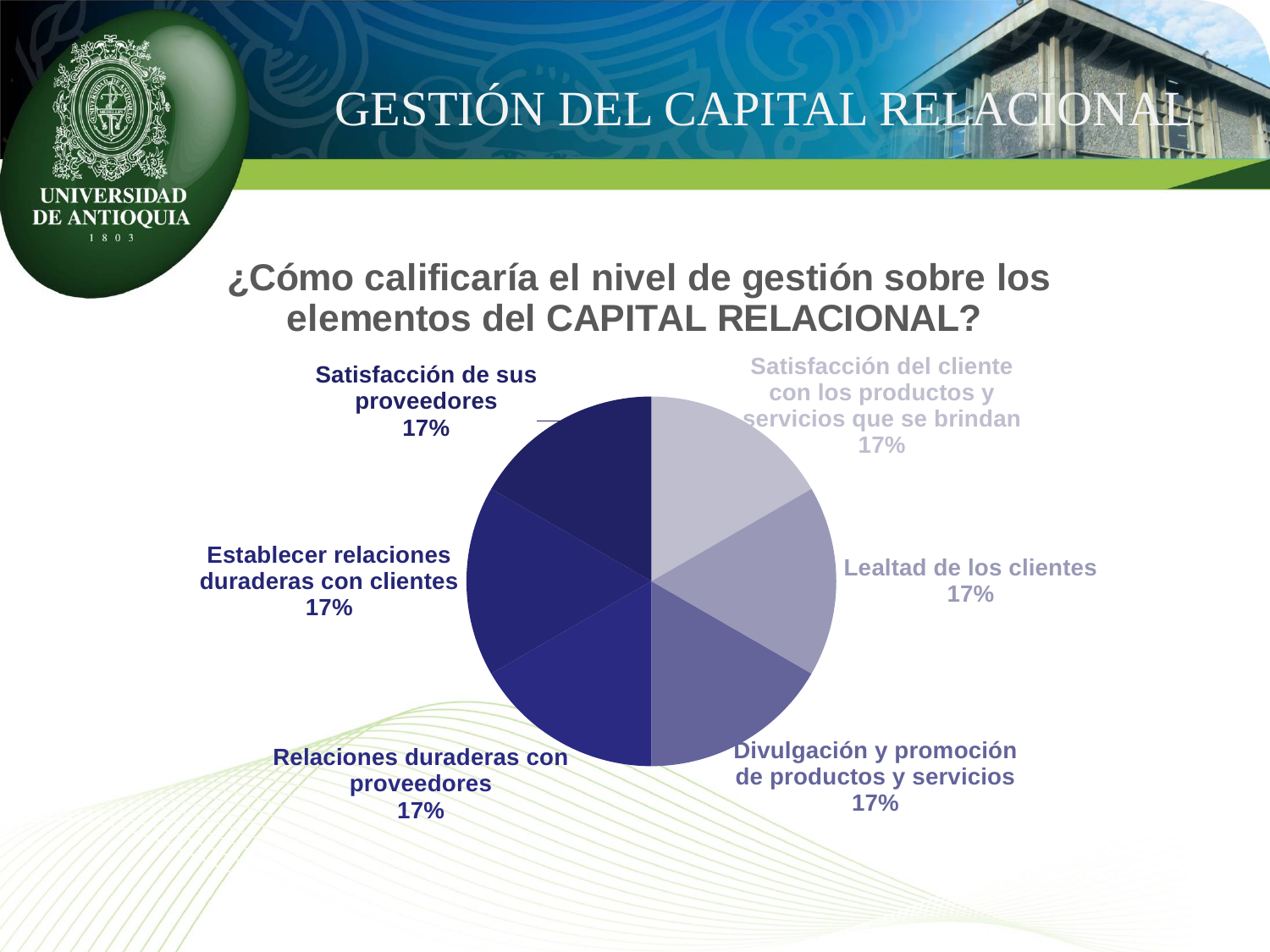
What kind of chart is shown on the slide? pie chart What share of the pie does "Lealtad de los clientes" represent? 17% Do all slices of the pie chart show the same percentage? Yes What is the value for "Relaciones duraderas con proveedores"? 17% How many slices does the pie chart have? 6 What is the difference between the values for "Lealtad de los clientes" and "Satisfacción de sus proveedores"? 0% What percentage is shown for "Satisfacción del cliente con los productos y servicios que se brindan"? 17% What share is shown for "Establecer relaciones duraderas con clientes"? 17% What is the value shown for "Satisfacción de sus proveedores"? 17% What percentage is labelled for "Divulgación y promoción de productos y servicios"? 17% What question does the chart's title ask? ¿Cómo calificaría el nivel de gestión sobre los elementos del CAPITAL RELACIONAL?